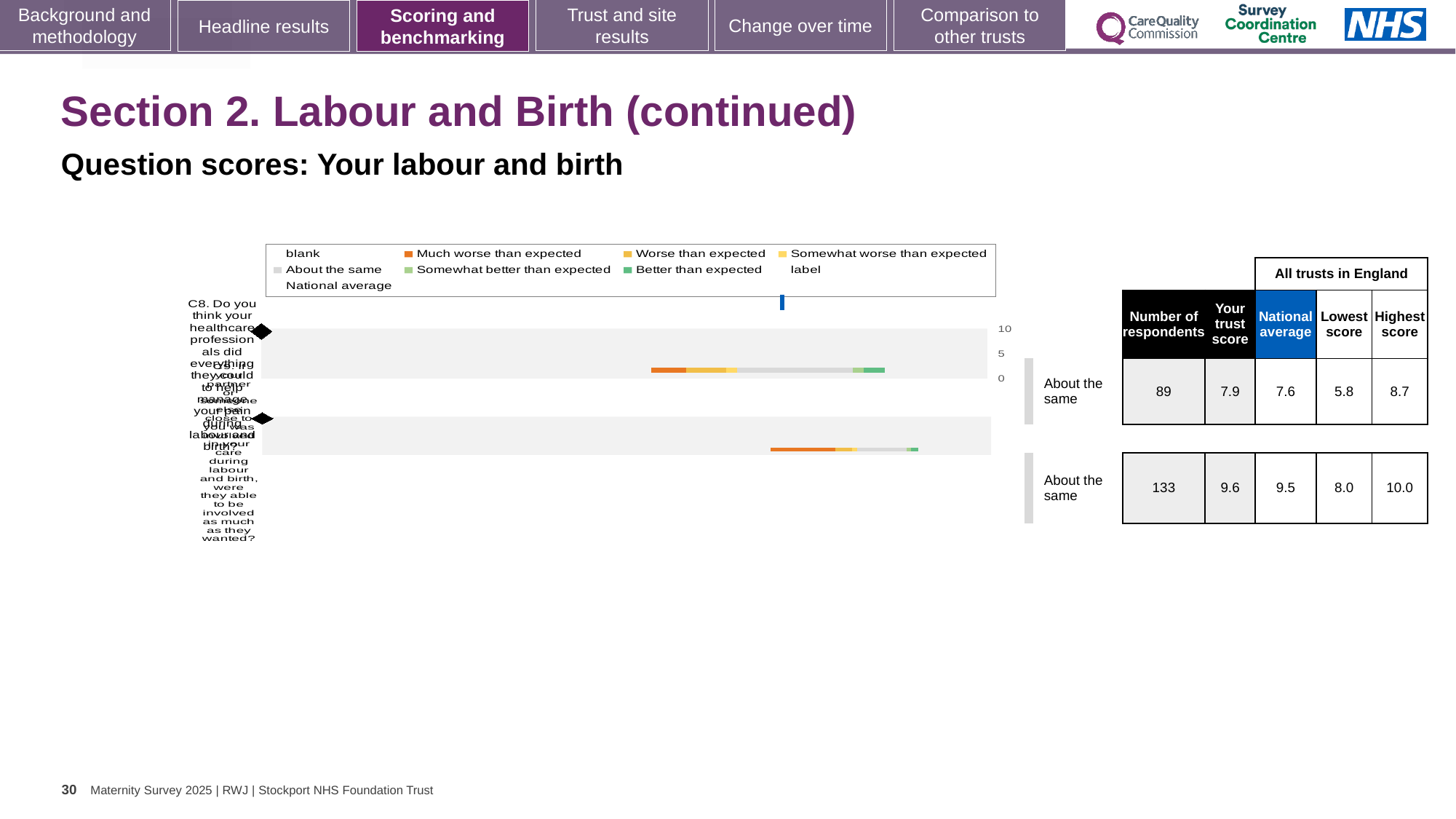
What kind of chart is shown on the slide? bar chart In the table next to the chart, what is the difference between the highest score and the lowest score for the top row (question C8)? 2.9 In the chart legend, which category is shown in orange? Much worse than expected In the table next to the chart, what is the lowest score for the top row (question C8)? 5.8 In the table next to the chart, what is the national average for the bottom row? 9.5 Which row in the table has more respondents, the top row or the bottom row? bottom row In the table next to the chart, what is the trust score for the top row (question C8)? 7.9 In the table next to the chart, what is the difference between the trust score and the national average for the top row (question C8)? 0.3 In the table next to the chart, what is the number of respondents for the top row (question C8)? 89 What benchmark label is shown beside both bars in the chart? About the same In the table next to the chart, what is the highest score for the bottom row? 10.0 How many question bars are plotted in the chart? 2